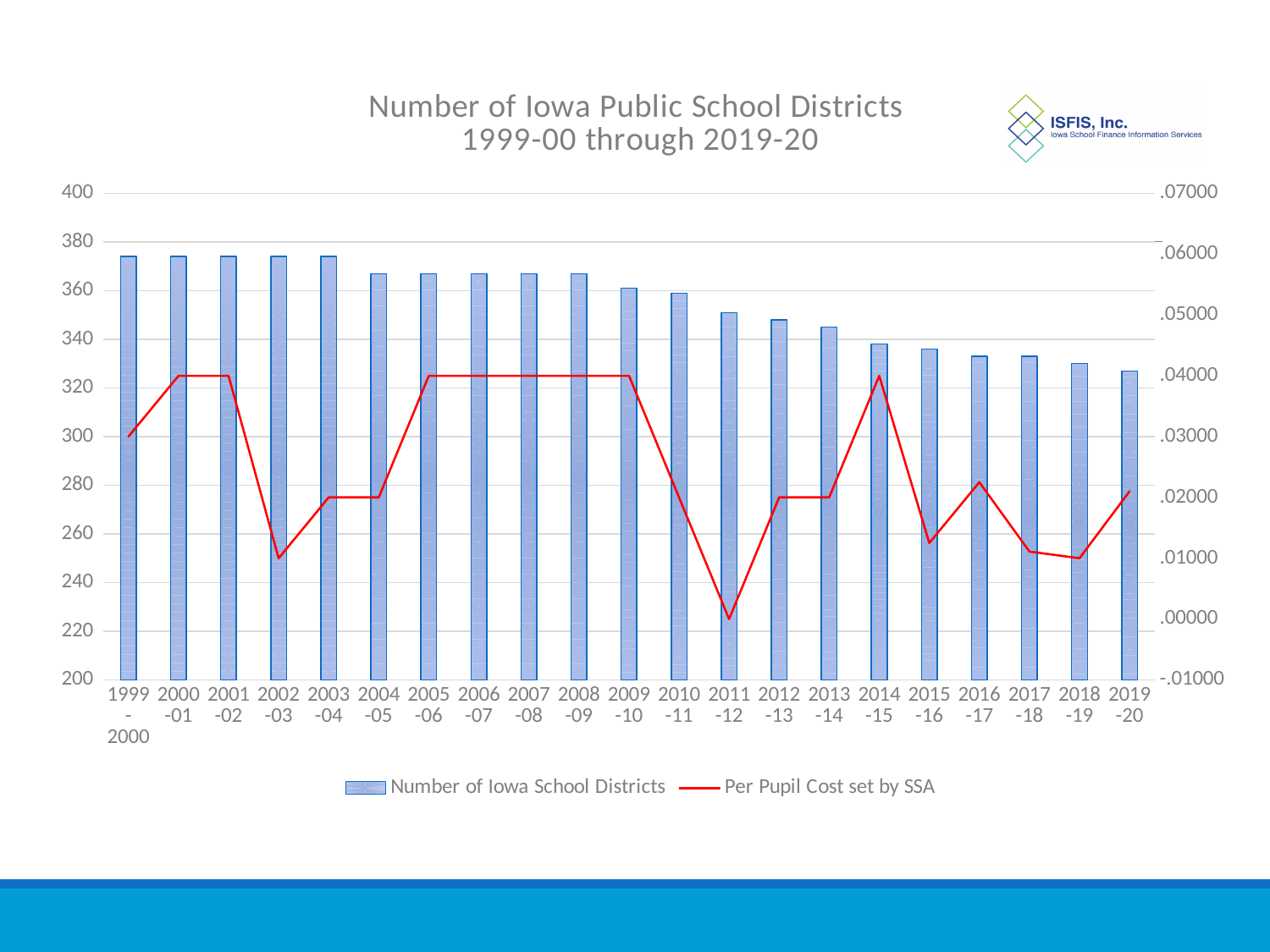
What is the Per Pupil Cost set by SSA for 2014-15? .04000 How many school years are shown along the x axis? 21 How many series does the legend list? 2 Does the Number of Iowa School Districts rise or fall from 1999-2000 to 2019-20? fall What is the Per Pupil Cost set by SSA for 2011-12? .00000 Is the Number of Iowa School Districts for 1999-2000 greater or less than 360? greater In which school year is the Per Pupil Cost set by SSA lowest? 2011-12 What is the title of the chart? Number of Iowa Public School Districts 1999-00 through 2019-20 Which year has more Iowa School Districts, 2004-05 or 2013-14? 2004-05 What is the Per Pupil Cost set by SSA for 2002-03? .01000 Is the Number of Iowa School Districts for 2019-20 greater or less than 340? less What kind of chart is shown on the slide? A combination bar and line chart